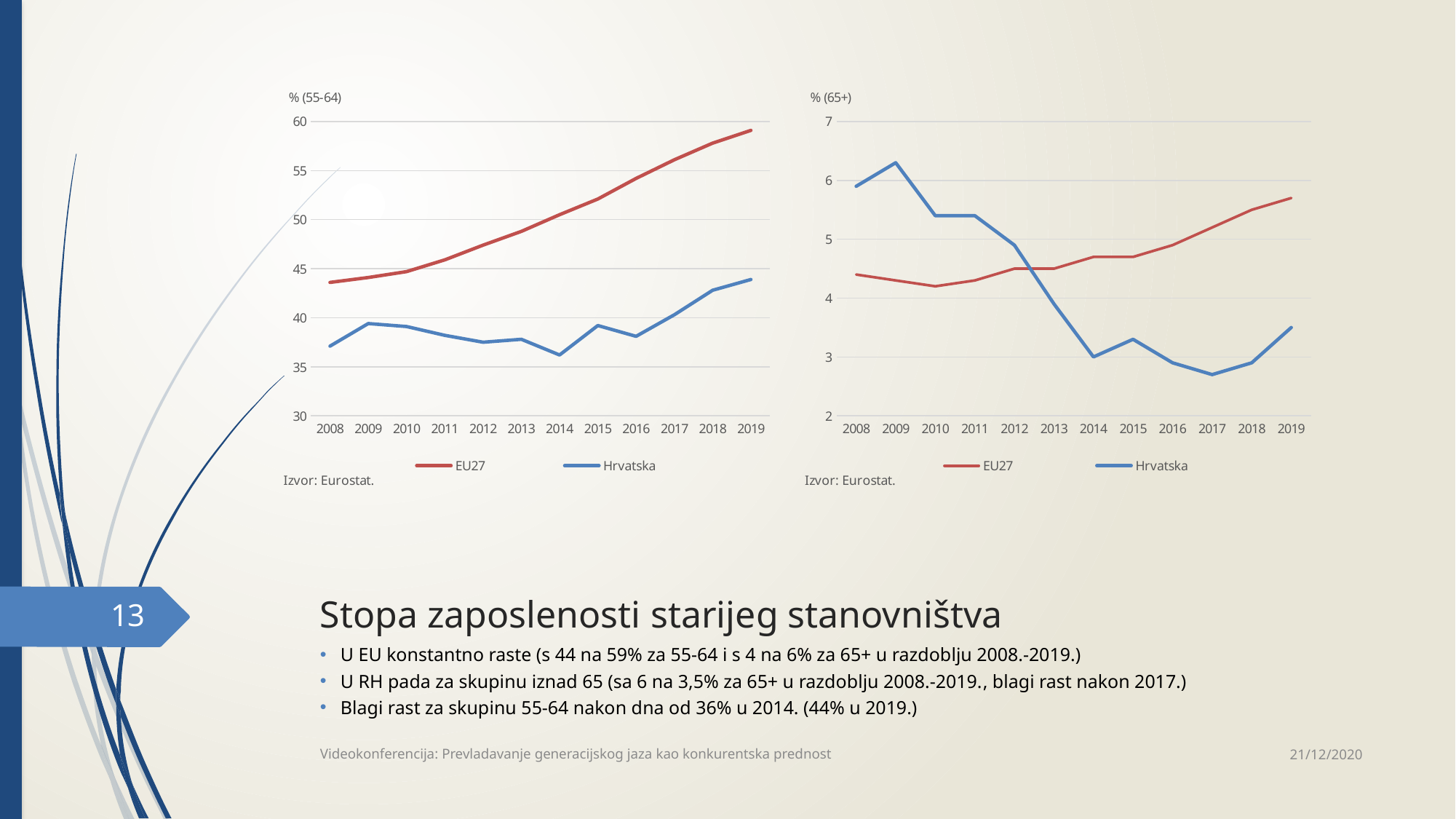
In the left chart titled "% (55-64)", in which year does the Hrvatska line reach its lowest value? 2014 In the right chart titled "% (65+)", in which year does the Hrvatska line reach its lowest value? 2017 In the left chart titled "% (55-64)", is the value for Hrvatska in 2014 greater or less than 40? less In the right chart titled "% (65+)", is the value for Hrvatska in 2017 greater or less than 3? less What kind of chart is the left chart titled "% (55-64)"? line chart How many years are plotted along the x axis of the left chart titled "% (55-64)"? 12 In the left chart titled "% (55-64)", is the value for EU27 in 2019 greater or less than 55? greater In the right chart titled "% (65+)", which series has the higher value in 2008, EU27 or Hrvatska? Hrvatska In the left chart titled "% (55-64)", does the EU27 line rise or fall from 2008 to 2019? rise How many series does the legend of the right chart titled "% (65+)" list? 2 In the right chart titled "% (65+)", which series has the higher value in 2019, EU27 or Hrvatska? EU27